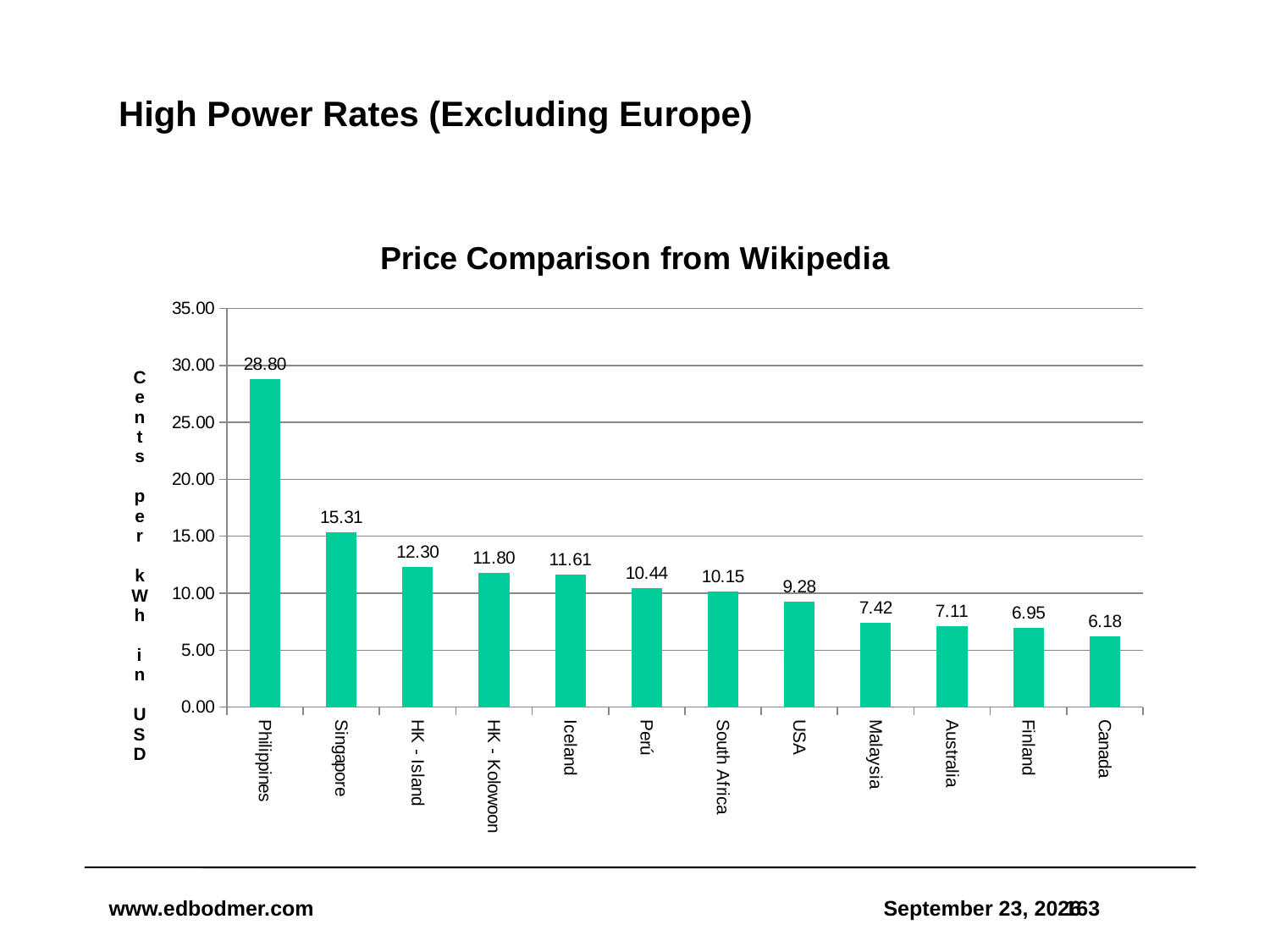
Which country has the lowest power rate? Canada Is the value for USA greater or less than 10.00? less Which country has the highest power rate? Philippines What is the value for the Philippines? 28.80 What is the value for Singapore? 15.31 What kind of chart is this? bar chart How many categories are shown on the x axis? 12 Do the values rise or fall from left to right along the x axis? fall What is the value for Canada? 6.18 Which is larger, the value for HK - Island or the value for Iceland? HK - Island What is the title of the chart? Price Comparison from Wikipedia What is the difference between the values for the Philippines and Singapore? 13.49